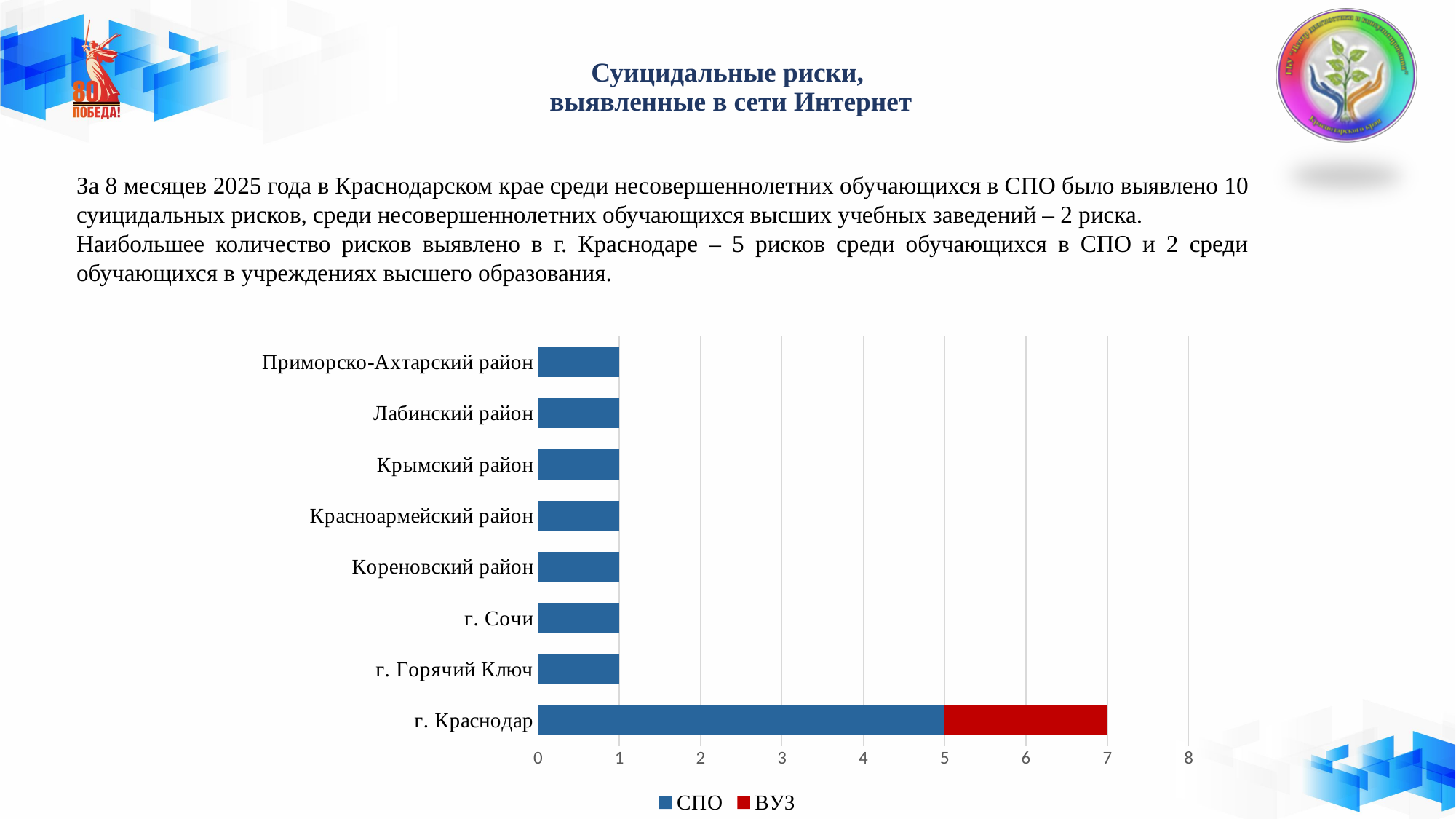
What is the ВУЗ value for г. Краснодар? 2 What is the total of the stacked bar for г. Краснодар? 7 How many series does the legend list? 2 What is the СПО value for г. Краснодар? 5 What is the difference between the СПО value for г. Краснодар and the СПО value for Лабинский район? 4 How many categories are shown on the chart? 8 What is the СПО value for г. Сочи? 1 Which is larger: the total for г. Краснодар or the total for Крымский район? г. Краснодар What are the two series named in the legend? СПО and ВУЗ What kind of chart is shown on the slide? bar chart Which category is the only one with a ВУЗ value shown? г. Краснодар Which category has the highest total value? г. Краснодар